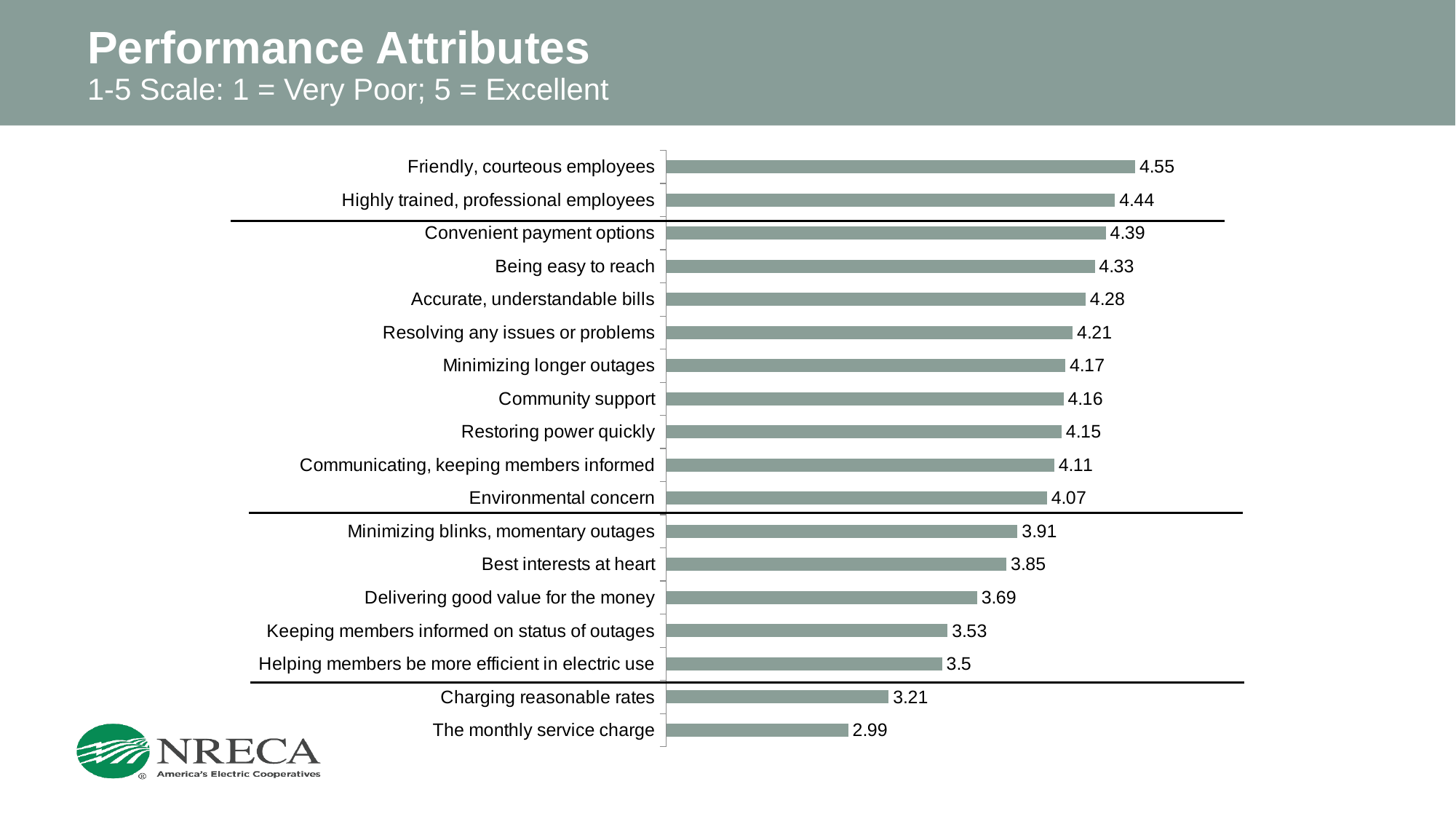
Which is larger, the value for Best interests at heart or the value for Minimizing blinks, momentary outages? Minimizing blinks, momentary outages Which attribute has the lowest value? The monthly service charge How many attributes are plotted in the chart? 18 What is the difference between the values for Convenient payment options and Charging reasonable rates? 1.18 What kind of chart is shown on the slide? Bar chart What is the title of the chart on the slide? Performance Attributes What is the value for Friendly, courteous employees? 4.55 What is the value for Delivering good value for the money? 3.69 What is the value for Environmental concern? 4.07 Which attribute has the highest value? Friendly, courteous employees What is the value for Keeping members informed on status of outages? 3.53 What is the difference between the values for Friendly, courteous employees and The monthly service charge? 1.56